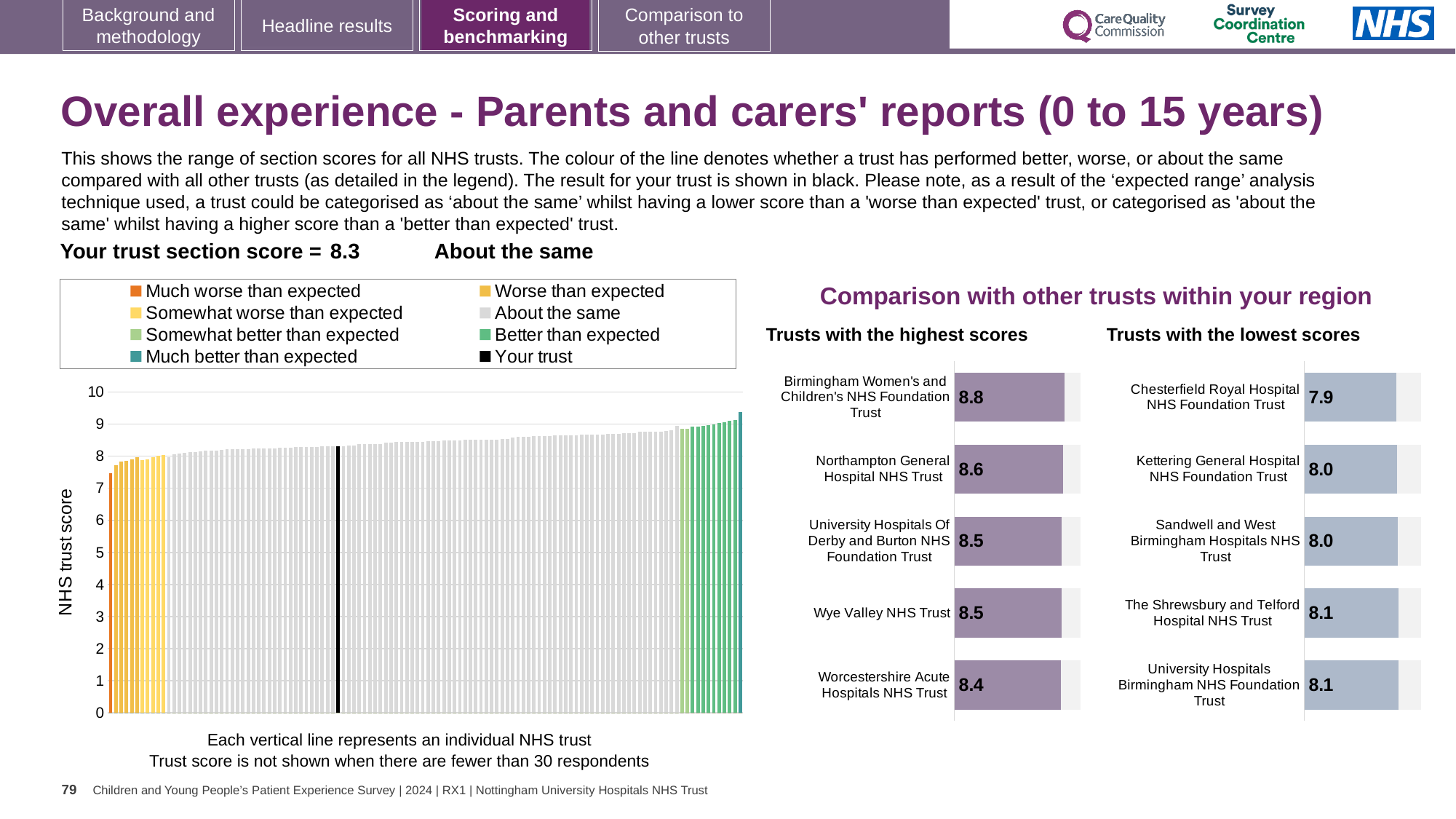
In the 'Trusts with the highest scores' chart, which trust has the highest score? Birmingham Women's and Children's NHS Foundation Trust Which has the larger score: Northampton General Hospital NHS Trust in the 'Trusts with the highest scores' chart or Kettering General Hospital NHS Foundation Trust in the 'Trusts with the lowest scores' chart? Northampton General Hospital NHS Trust In the 'Trusts with the lowest scores' chart, which trust has the lowest score? Chesterfield Royal Hospital NHS Foundation Trust In the large chart on the left, is the value for the black bar (Your trust) greater or less than 8? greater In the 'Trusts with the highest scores' chart, how many trusts are shown? 5 In the large chart on the left, what is the label on the vertical axis? NHS trust score In the 'Trusts with the lowest scores' chart, what is the score for Chesterfield Royal Hospital NHS Foundation Trust? 7.9 In the 'Trusts with the highest scores' chart, what is the score for Northampton General Hospital NHS Trust? 8.6 What kind of chart is the large chart on the left showing NHS trust scores? bar chart In the large chart on the left, how many entries does the legend list? 8 In the 'Trusts with the highest scores' chart, what is the difference between the scores of Birmingham Women's and Children's NHS Foundation Trust and Worcestershire Acute Hospitals NHS Trust? 0.4 In the large chart on the left, do the trust scores rise or fall from left to right along the x axis? rise